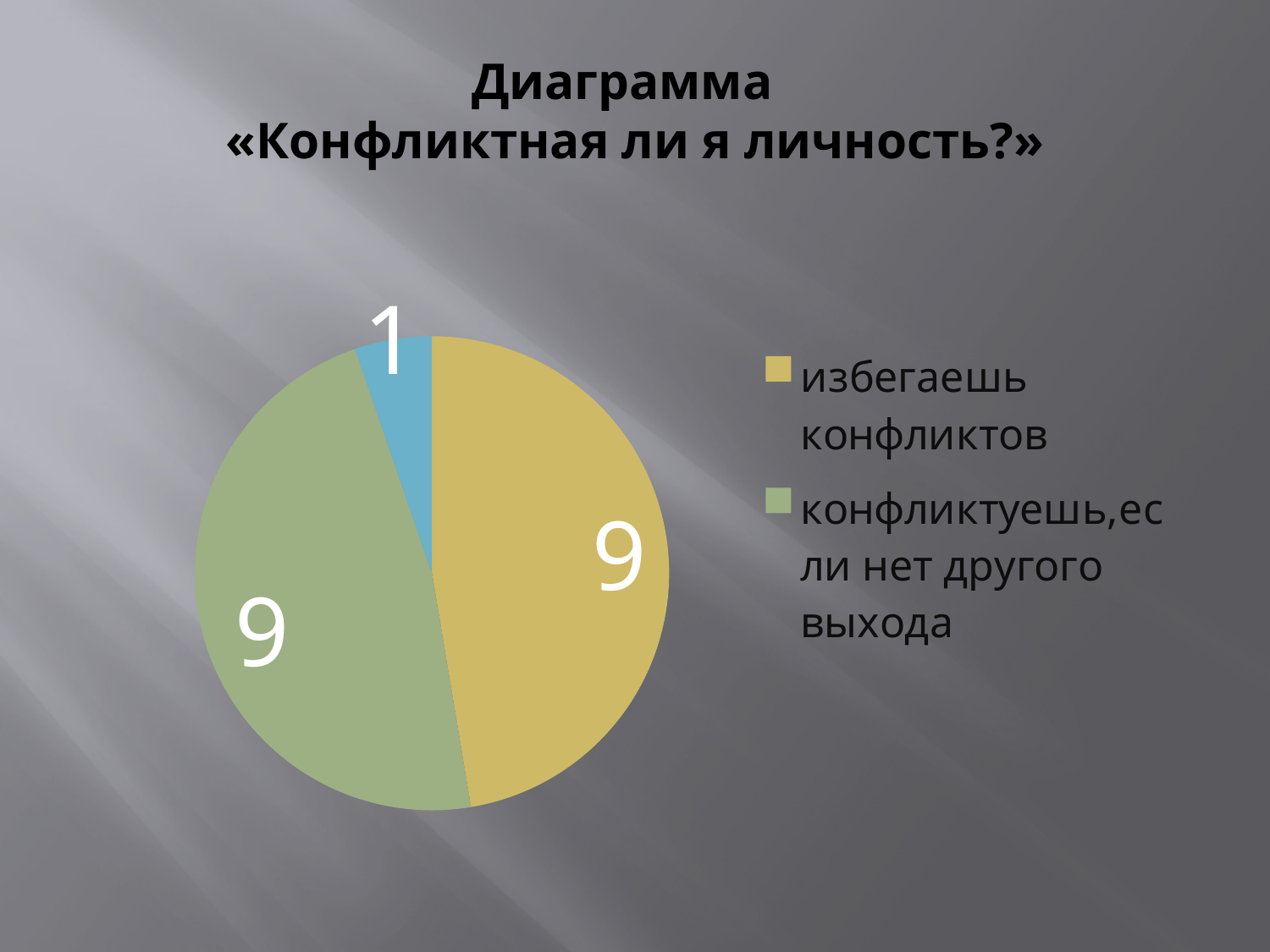
What colour is the slice for «избегаешь конфликтов»? yellow How many entries does the legend list? 2 What is the total of all the values shown on the pie chart? 19 What is the title of the chart? Диаграмма «Конфликтная ли я личность?» Which is larger: the value for «избегаешь конфликтов» or the value for «конфликтуешь, если нет другого выхода»? they are equal What is the value for «избегаешь конфликтов»? 9 How many slices does the pie chart have? 3 What type of chart is shown on the slide? pie chart What is the difference between the values for «избегаешь конфликтов» and «конфликтуешь, если нет другого выхода»? 0 What is the value for «конфликтуешь, если нет другого выхода»? 9 What is the smallest value shown on the pie chart? 1